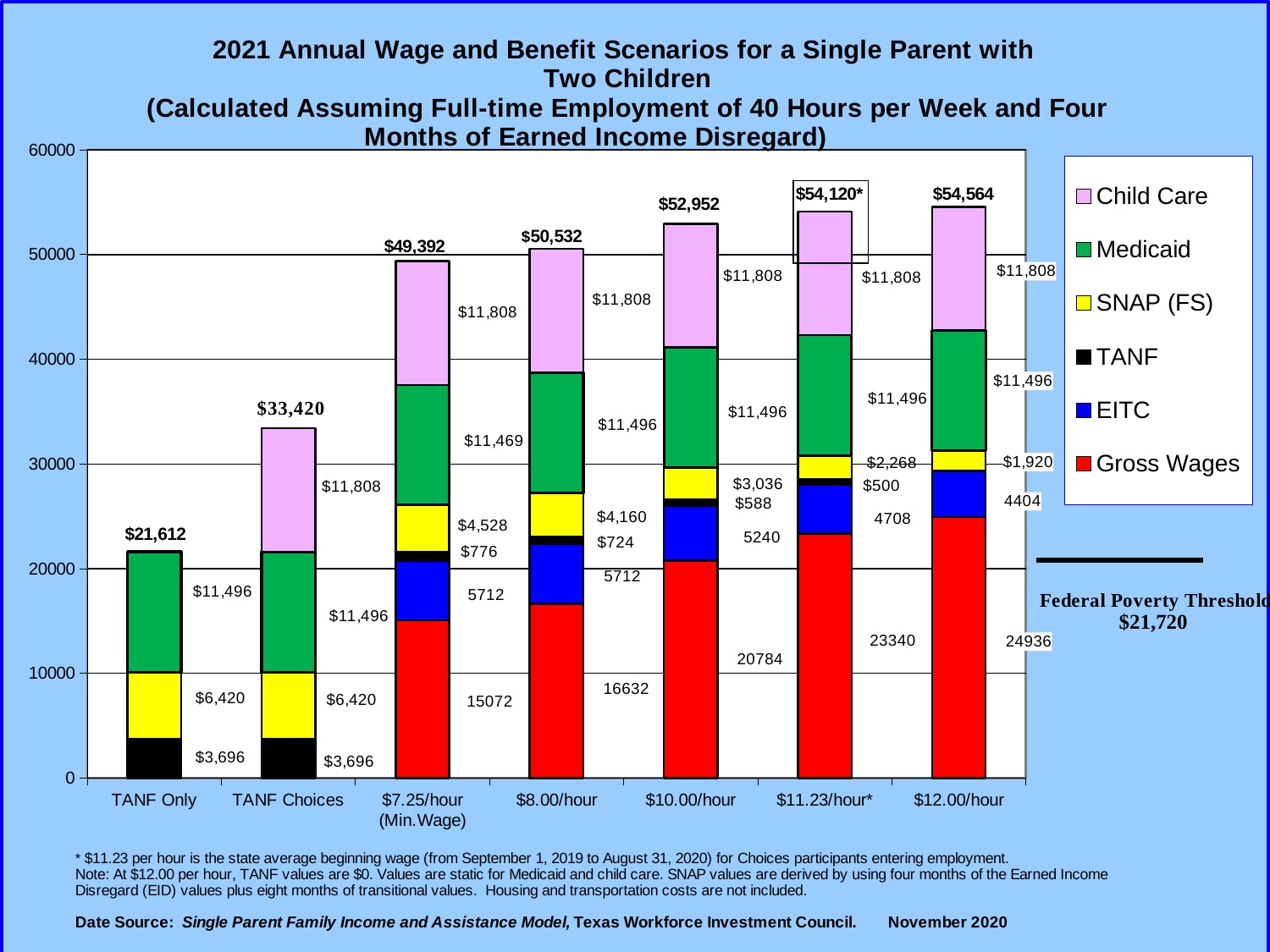
What Federal Poverty Threshold value is shown on the slide? $21,720 Do the totals rise or fall moving from TANF Only to $12.00/hour along the x axis? Rise What kind of chart is shown on the slide? Stacked bar chart What is the total annual wage and benefit value for the $10.00/hour scenario? $52,952 Which scenario has the highest total? $12.00/hour Which is larger, the EITC value for $7.25/hour (Min.Wage) or the EITC value for $12.00/hour? $7.25/hour (Min.Wage) How many series does the legend list? 6 What is the SNAP (FS) value for the $8.00/hour scenario? $4,160 What is the Gross Wages value for the $11.23/hour* scenario? 23340 How many wage/benefit scenarios (categories) are shown on the x axis? 7 Which scenario has the lowest total? TANF Only What is the difference between the totals for TANF Choices and TANF Only? $11,808